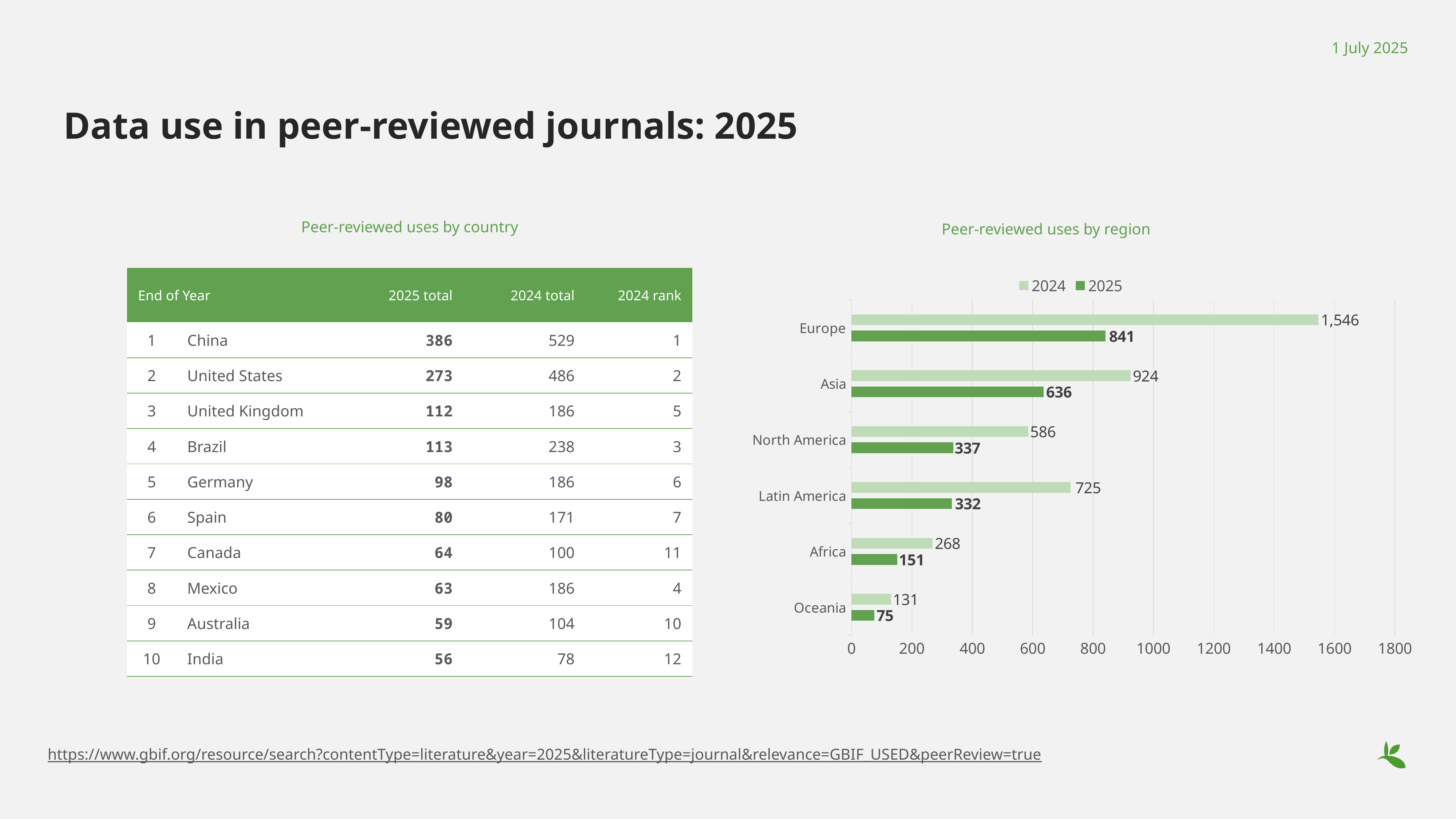
In the 'Peer-reviewed uses by region' chart, what is the difference between the 2024 and 2025 values for Europe? 705 In the 'Peer-reviewed uses by region' chart, what is the 2025 value for Europe? 841 What kind of chart is 'Peer-reviewed uses by region'? Bar chart How many regions are shown in the 'Peer-reviewed uses by region' chart? 6 In the 'Peer-reviewed uses by region' chart, which region has the highest 2024 value? Europe In the 'Peer-reviewed uses by region' chart, which is larger: the 2025 value for North America or the 2025 value for Latin America? North America In the 'Peer-reviewed uses by region' chart, is the 2024 value for Africa greater or less than 200? greater In the 'Peer-reviewed uses by region' chart, what is the 2025 value for Oceania? 75 In the 'Peer-reviewed uses by region' chart, what is the difference between the 2024 values for Latin America and North America? 139 In the 'Peer-reviewed uses by region' chart, which region has the lowest 2025 value? Oceania In the 'Peer-reviewed uses by region' chart, what is the 2024 value for Asia? 924 How many series does the legend of the 'Peer-reviewed uses by region' chart list? 2